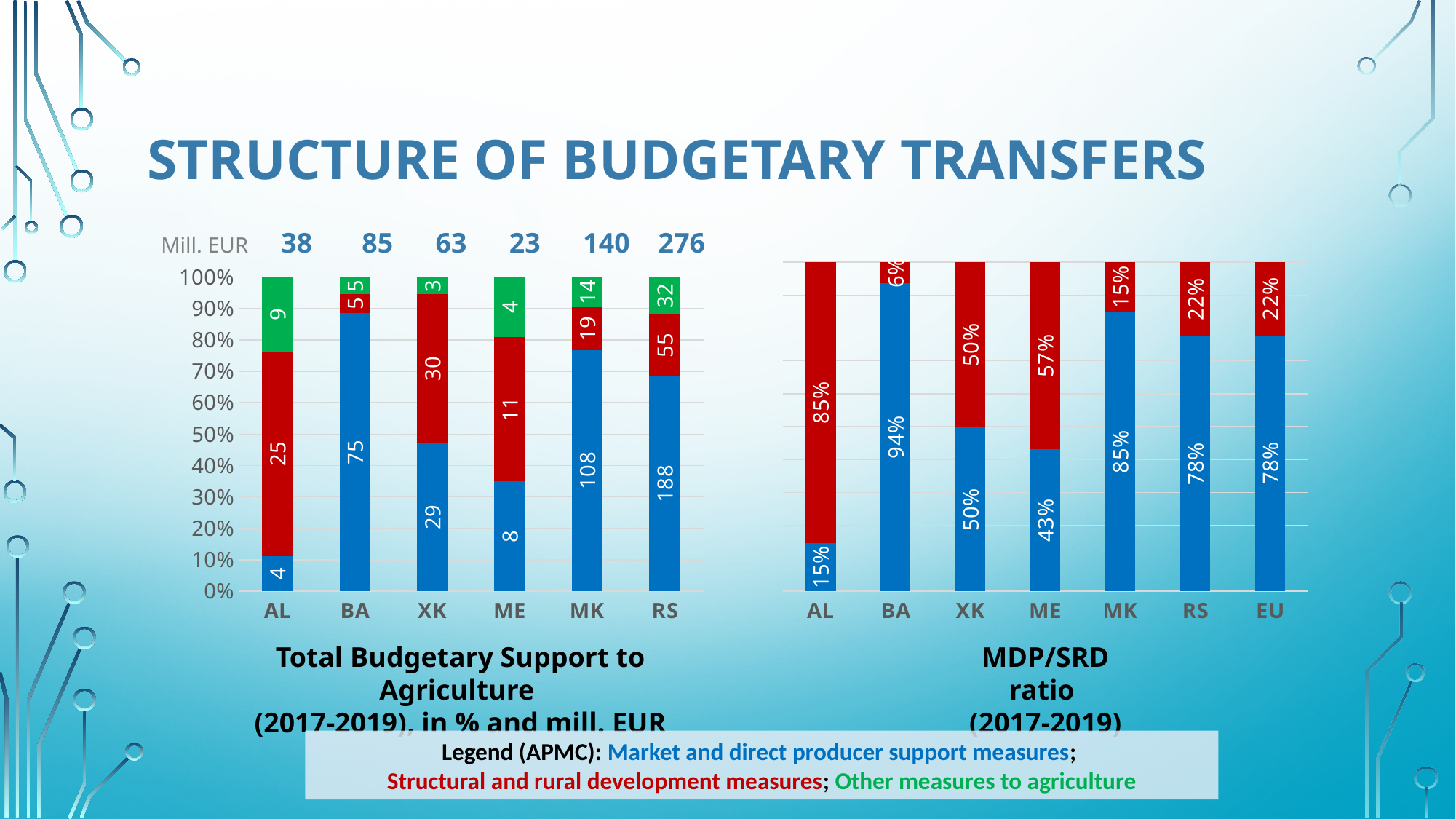
In the MDP/SRD ratio chart, what is the red (structural and rural development) share for ME? 57% In the Total Budgetary Support to Agriculture chart, which country has the lowest total in mill. EUR? ME In the Total Budgetary Support to Agriculture chart, what is the value of the blue (market and direct producer support) segment for MK? 108 In the MDP/SRD ratio chart, which country has the lowest blue (market and direct producer support) share? AL What kind of chart is the Total Budgetary Support to Agriculture chart? Stacked bar chart In the Total Budgetary Support to Agriculture chart, what is the difference between the red (structural and rural development) values for RS and MK? 36 In the Total Budgetary Support to Agriculture chart, which country has the highest total in mill. EUR? RS In the MDP/SRD ratio chart, which has the larger blue (market and direct producer support) share, MK or RS? MK How many measure categories does the legend (APMC) list? 3 In the MDP/SRD ratio chart, what is the blue (market and direct producer support) share for BA? 94% In the Total Budgetary Support to Agriculture chart, what total in mill. EUR is shown above the RS bar? 276 How many countries/regions are shown on the x axis of the MDP/SRD ratio chart? 7